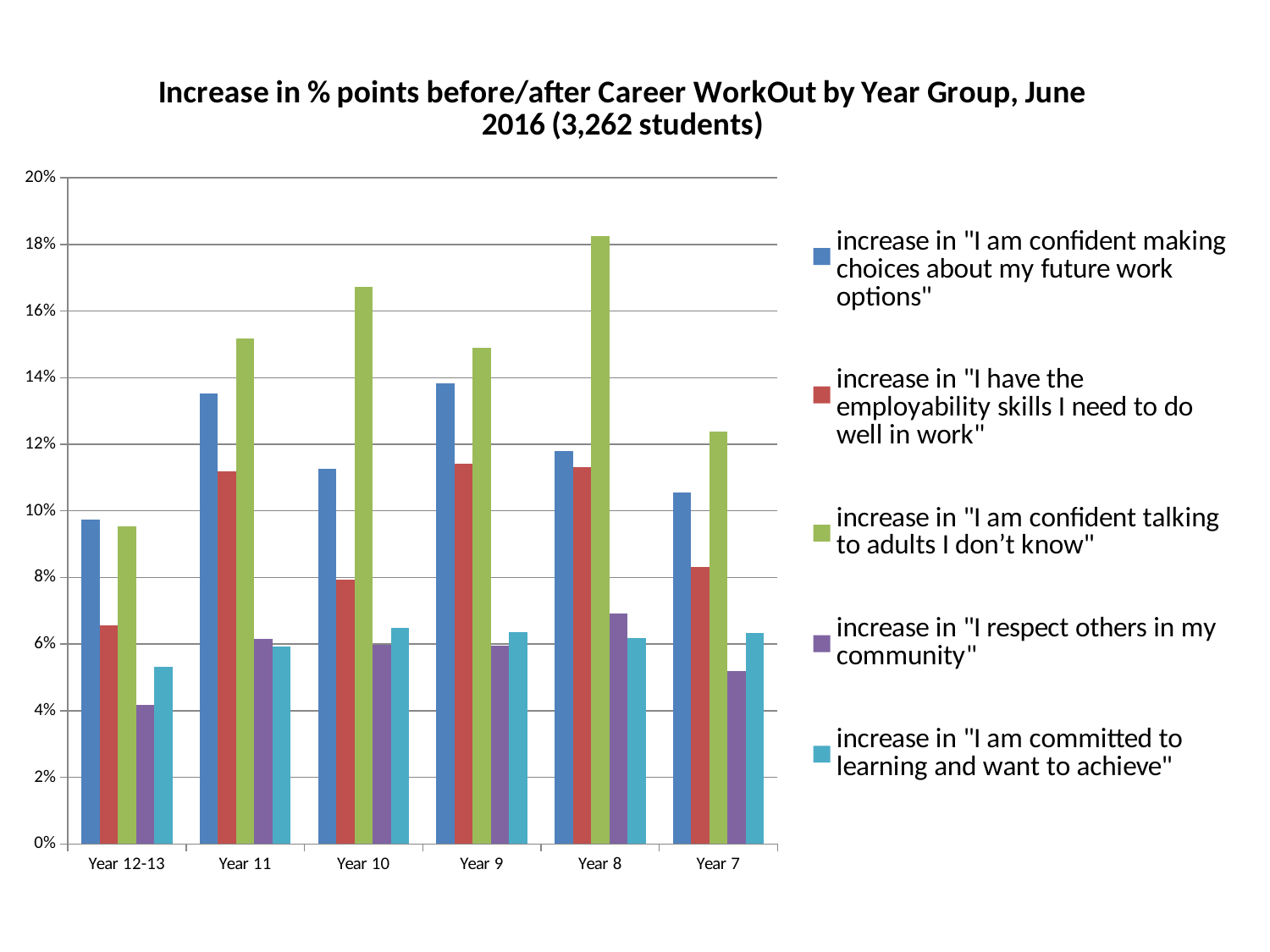
How many series does the legend list? 5 For which year group is the increase in "I am confident talking to adults I don't know" highest? Year 8 What is the title of the chart? Increase in % points before/after Career WorkOut by Year Group, June 2016 (3,262 students) For Year 10, which is larger: the increase in "I am confident talking to adults I don't know" or the increase in "I am confident making choices about my future work options"? increase in "I am confident talking to adults I don't know" For Year 12-13, which is larger: the increase in "I am confident making choices about my future work options" or the increase in "I have the employability skills I need to do well in work"? increase in "I am confident making choices about my future work options" For which year group is the increase in "I am confident talking to adults I don't know" lowest? Year 12-13 What kind of chart is shown on the slide? bar chart Is the increase in "I am confident talking to adults I don't know" for Year 8 greater or less than 16%? greater Is the increase in "I respect others in my community" for Year 12-13 greater or less than 6%? less For which year group is the increase in "I respect others in my community" lowest? Year 12-13 Is the increase in "I am confident making choices about my future work options" for Year 11 greater or less than 12%? greater How many year groups are shown on the x axis? 6